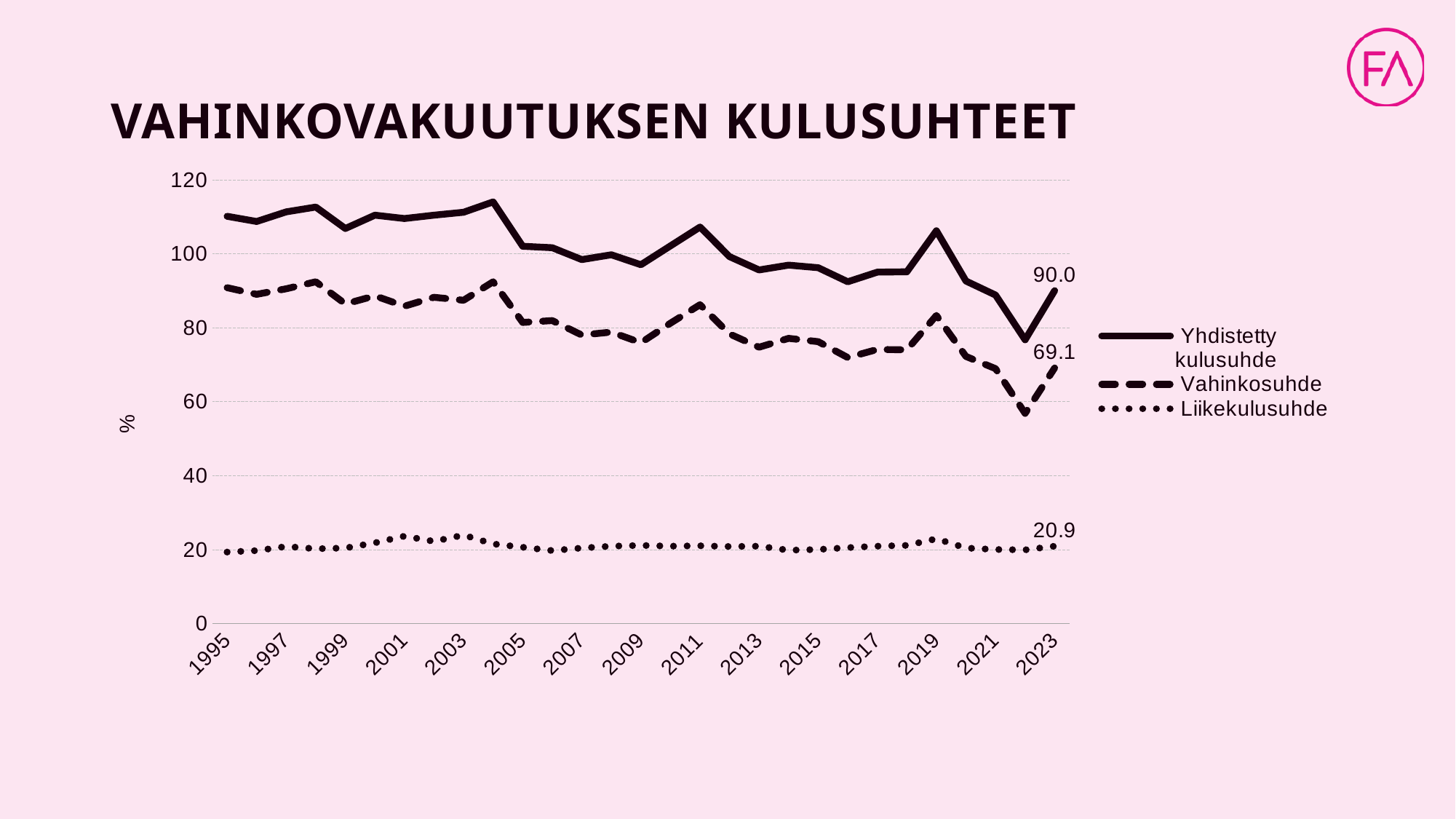
Does Yhdistetty kulusuhde overall rise or fall from 1995 to 2023? Fall Is the value for Liikekulusuhde in 2001 greater or less than 40? less How many series does the legend list? 3 Which series has the highest value in 2023? Yhdistetty kulusuhde What is the value of Vahinkosuhde in 2023? 69.1 What is the value of Yhdistetty kulusuhde in 2023? 90.0 What is the difference between Yhdistetty kulusuhde and Vahinkosuhde in 2023? 20.9 In 2023, which is larger: Vahinkosuhde or Liikekulusuhde? Vahinkosuhde What kind of chart is shown on the slide? Line chart Which series has the lowest value in 2023? Liikekulusuhde Is the value for Yhdistetty kulusuhde in 1995 greater or less than 100? greater What is the value of Liikekulusuhde in 2023? 20.9